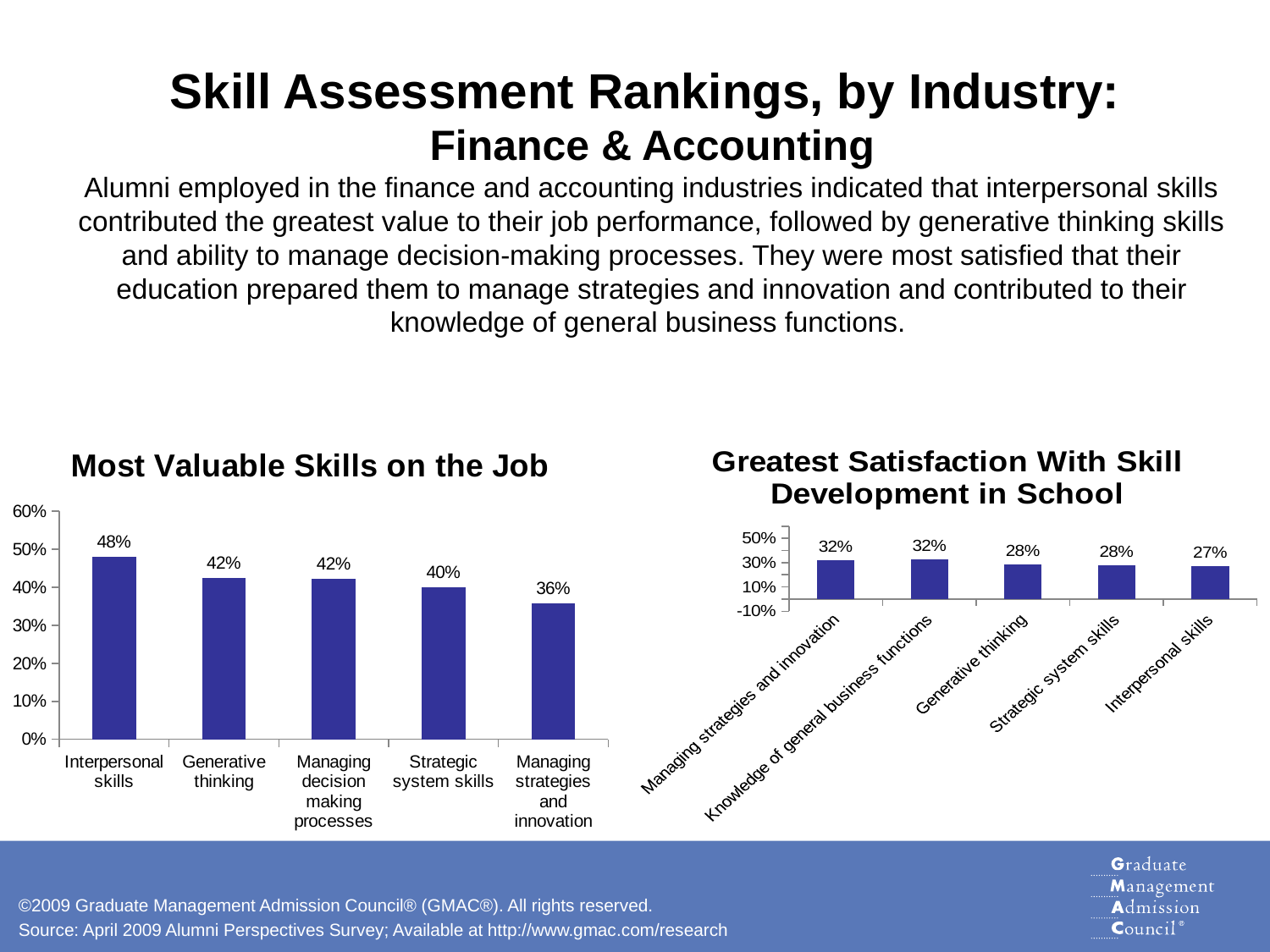
In the 'Most Valuable Skills on the Job' chart, how many categories are shown? 5 In the 'Most Valuable Skills on the Job' chart, what is the value for Managing strategies and innovation? 36% What kind of chart is the 'Most Valuable Skills on the Job' chart? Bar chart In the 'Greatest Satisfaction With Skill Development in School' chart, what is the difference between Managing strategies and innovation and Strategic system skills? 4% In the 'Greatest Satisfaction With Skill Development in School' chart, is the value for Knowledge of general business functions greater or less than 30%? greater In the 'Greatest Satisfaction With Skill Development in School' chart, which category has the lowest value? Interpersonal skills In the 'Greatest Satisfaction With Skill Development in School' chart, what is the value for Generative thinking? 28% In the 'Greatest Satisfaction With Skill Development in School' chart, what is the value for Interpersonal skills? 27% In the 'Most Valuable Skills on the Job' chart, which category has the lowest value? Managing strategies and innovation In the 'Most Valuable Skills on the Job' chart, what is the value for Interpersonal skills? 48% In the 'Most Valuable Skills on the Job' chart, what is the difference between Interpersonal skills and Strategic system skills? 8% In the 'Most Valuable Skills on the Job' chart, which category has the highest value? Interpersonal skills